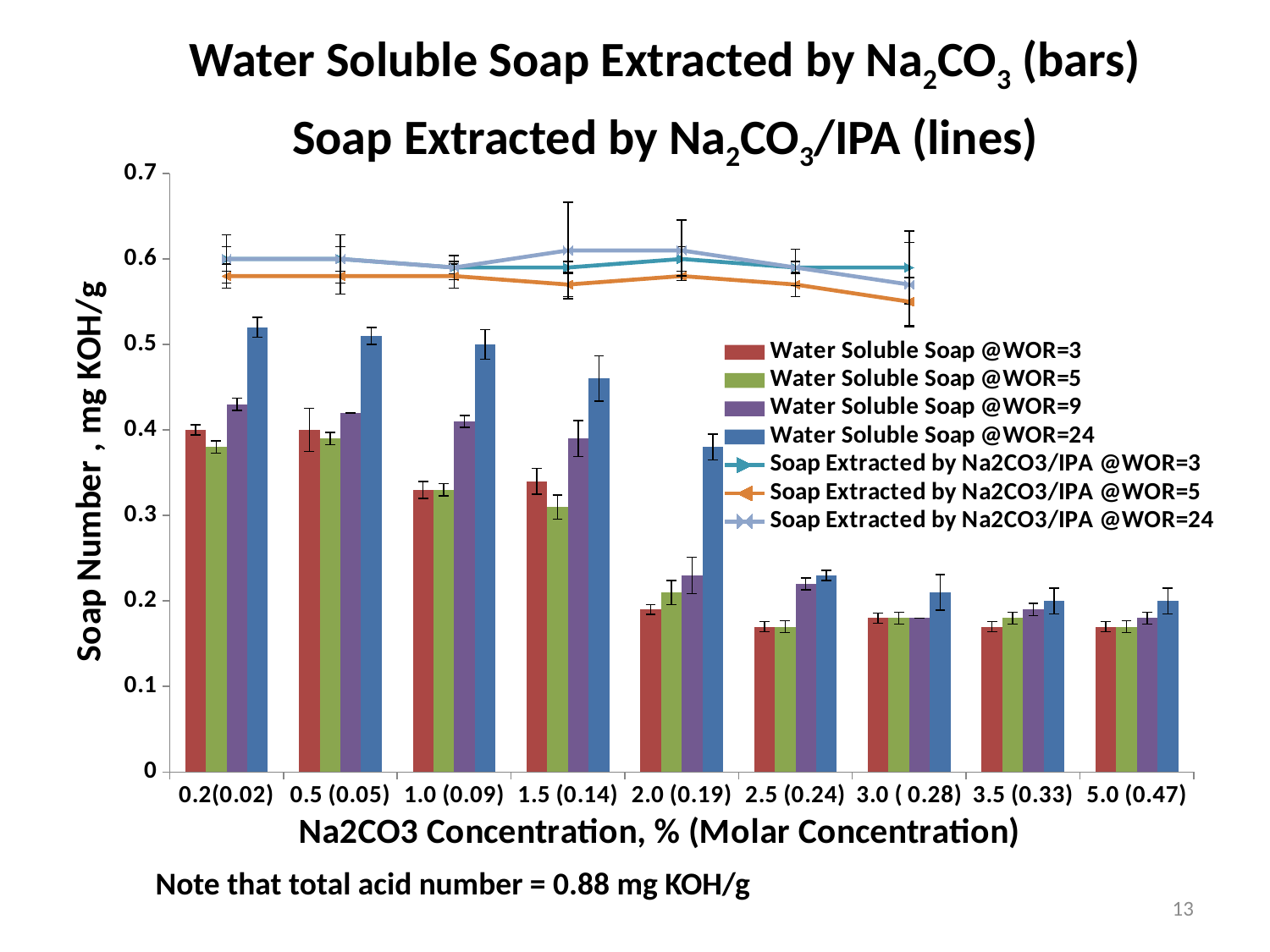
How many Na2CO3 concentration categories are shown on the x axis? 9 What is the value of Water Soluble Soap @WOR=24 at 1.0 (0.09)? 0.5 According to the note below the chart, what is the total acid number? 0.88 mg KOH/g Do the Water Soluble Soap bar values generally rise or fall as Na2CO3 concentration increases along the x axis? Fall What is the y-axis title of the chart? Soap Number , mg KOH/g How many series does the legend list? 7 Is the value for Water Soluble Soap @WOR=3 at 2.5 (0.24) greater or less than 0.2? less What is the value of Water Soluble Soap @WOR=3 at 0.2(0.02)? 0.4 At 2.0 (0.19), which is larger: Water Soluble Soap @WOR=24 or Water Soluble Soap @WOR=3? Water Soluble Soap @WOR=24 Is the value for Water Soluble Soap @WOR=24 at 1.5 (0.14) greater or less than 0.4? greater What kind of chart is shown on the slide? A combination bar and line chart